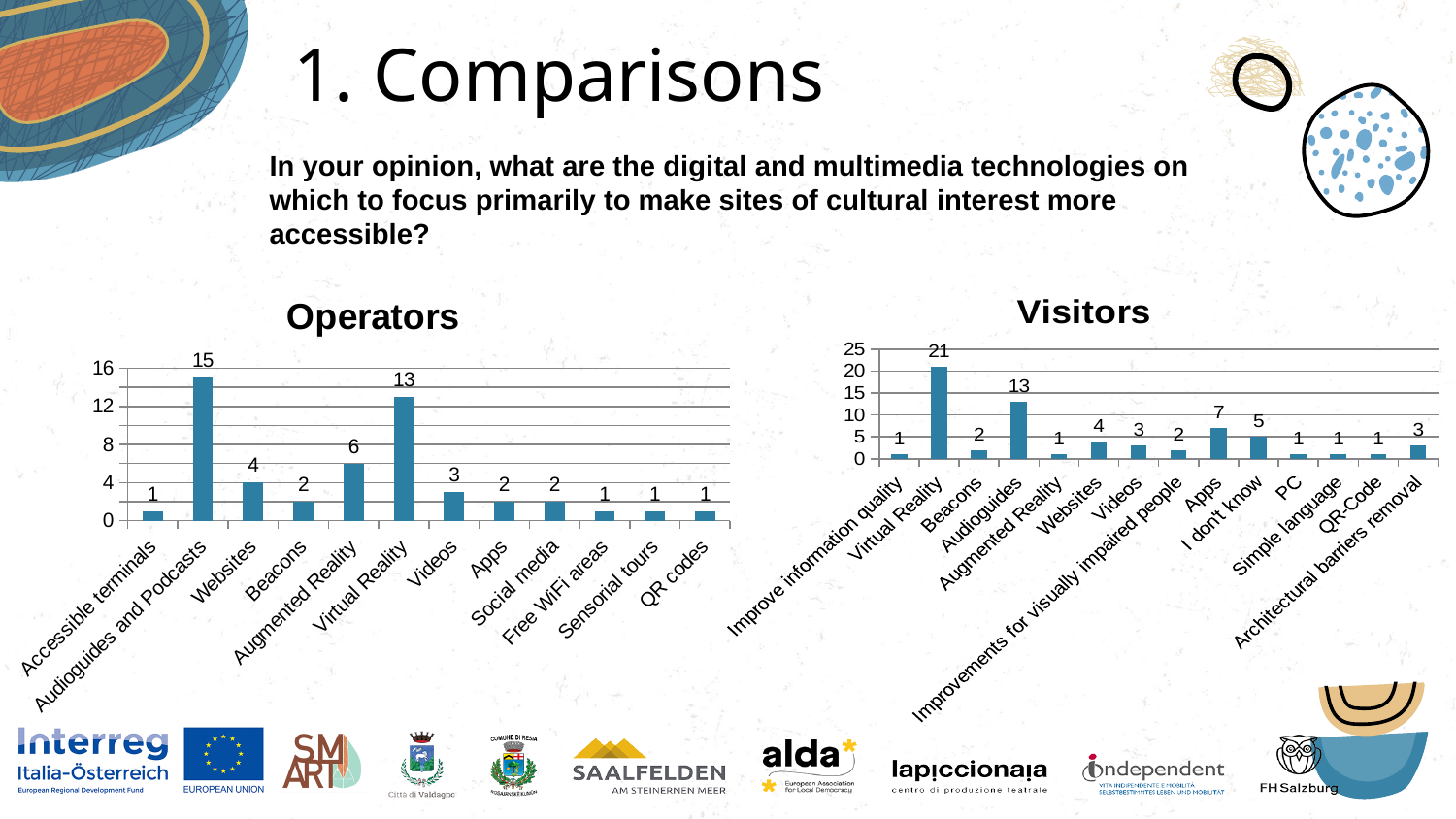
In the Visitors chart, which category has the highest value? Virtual Reality In the Operators chart, which category has the highest value? Audioguides and Podcasts In the Operators chart, which is larger, Augmented Reality or Websites? Augmented Reality In the Visitors chart, what is the value for Apps? 7 In the Visitors chart, what is the difference between Virtual Reality and Audioguides? 8 In the Operators chart, what is the value for Virtual Reality? 13 How many categories are shown in the Operators chart? 12 In the Operators chart, what is the difference between Audioguides and Podcasts and Virtual Reality? 2 In the Operators chart, what is the value for Audioguides and Podcasts? 15 How many categories are shown in the Visitors chart? 14 In the Visitors chart, which is larger, Apps or I don't know? Apps What type of chart is the Operators chart? Bar chart